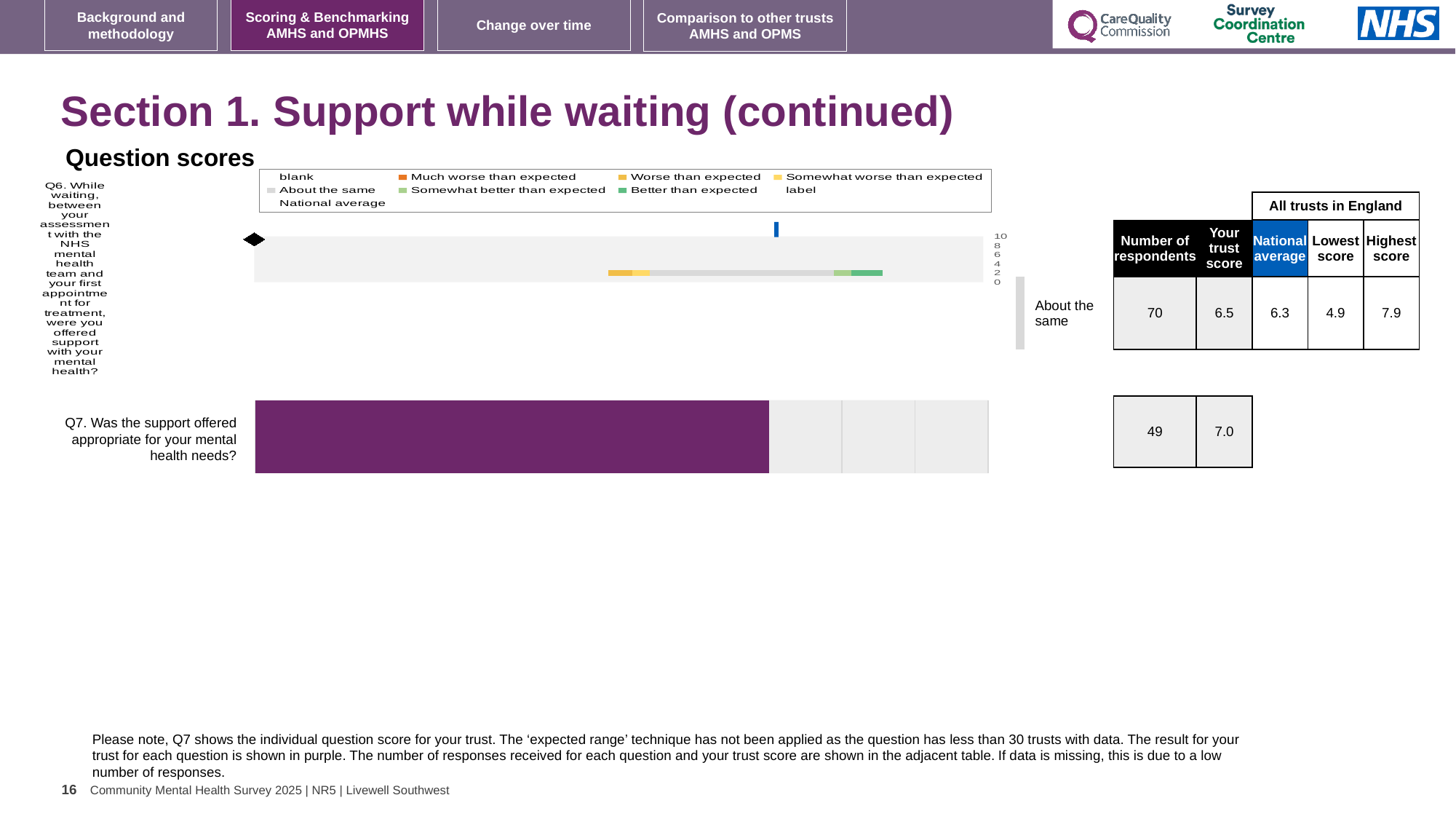
What is the national average for Q6? 6.3 For Q6, which is larger: the trust score or the national average? the trust score What is the highest tick value shown on the axis of the Q6 chart? 10 What category label is shown next to the Q6 chart describing the trust's result? About the same What is the difference between the highest and lowest scores for Q6? 3.0 What is the number of respondents for Q6? 70 What kind of chart is used to show the Q6 result? bar chart What is the lowest score among all trusts in England for Q6? 4.9 What is the trust score for Q6? 6.5 What is the highest score among all trusts in England for Q6? 7.9 What colour is the bar shown for Q7? purple What is the trust score for Q7? 7.0